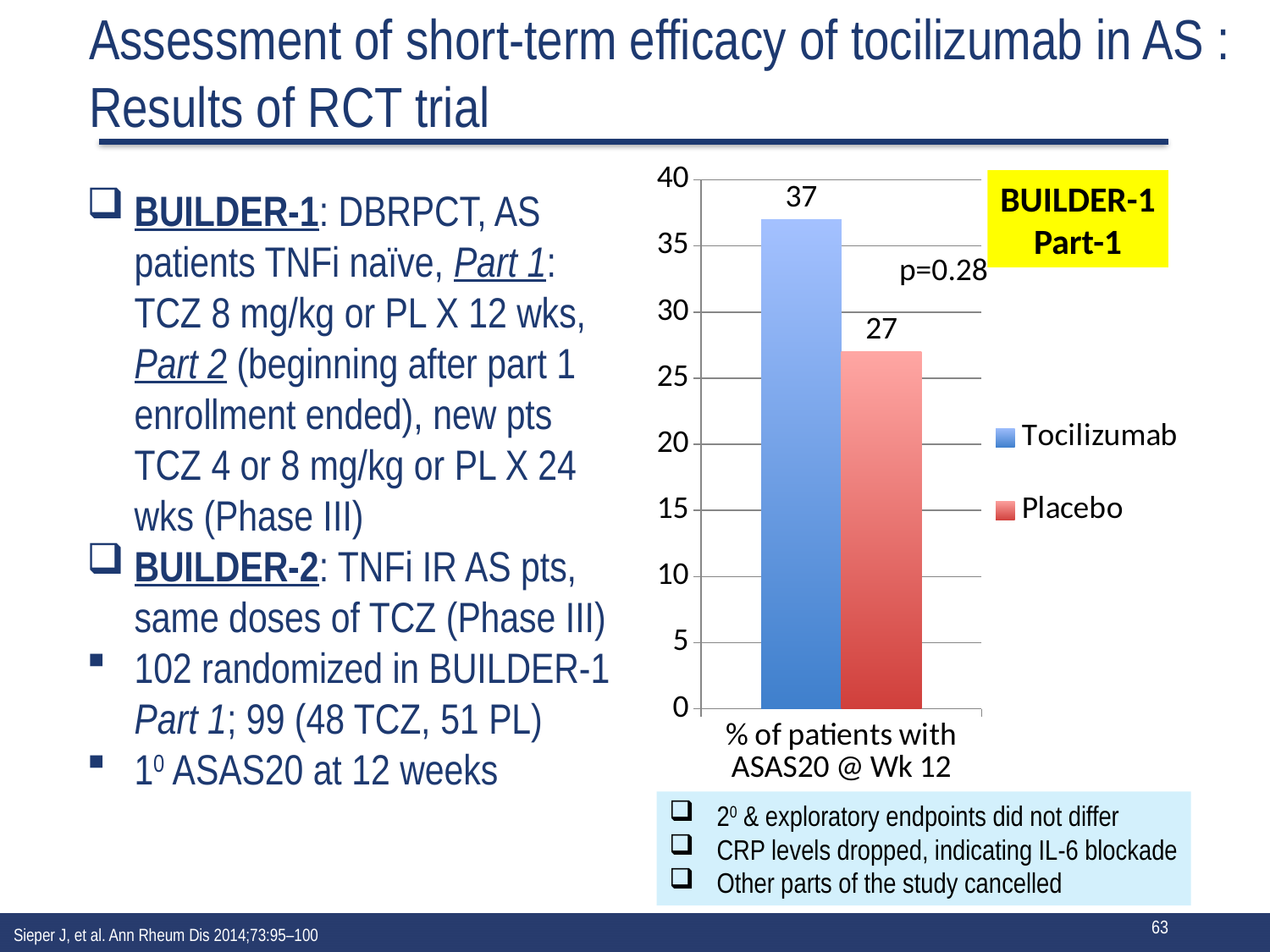
What is the difference between the Tocilizumab and Placebo values? 10 What is the category label on the x axis of the chart? % of patients with ASAS20 @ Wk 12 Is the value for Tocilizumab greater or less than 35? greater Is the value for Placebo greater or less than 30? less Which series has the lowest value in the chart? Placebo What is the value for Tocilizumab in the chart? 37 What p-value is shown on the chart? p=0.28 What is the maximum value shown on the y axis of the chart? 40 How many series does the legend list? 2 Which series has the higher value, Tocilizumab or Placebo? Tocilizumab What is the value for Placebo in the chart? 27 What kind of chart is shown on the slide? bar chart